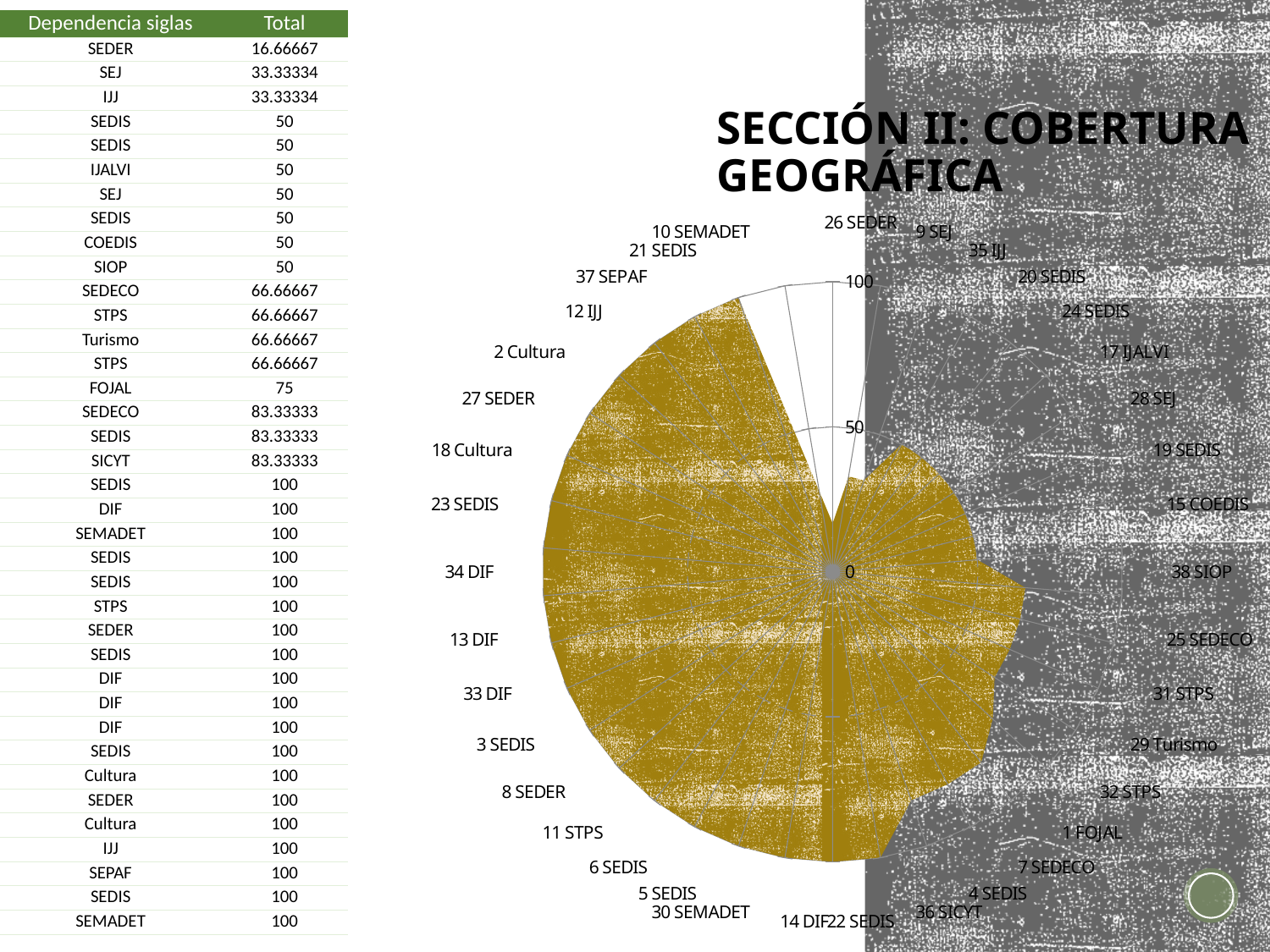
Is the value for 25 SEDECO greater or less than 50? greater Is the value for 9 SEJ greater or less than 50? less Is the value for 7 SEDECO greater or less than 50? greater What kind of chart is shown on the slide? radar chart Which is larger, the value for 26 SEDER or the value for 12 IJJ? 12 IJJ What is the highest value shown on the chart's axis scale? 100 What is the value for 34 DIF on the radar chart? 100 Which category has the lowest value on the radar chart? 26 SEDER What is the value for 12 IJJ on the radar chart? 100 Which is larger, the value for 34 DIF or the value for 38 SIOP? 34 DIF What is the value for 38 SIOP on the radar chart? 50